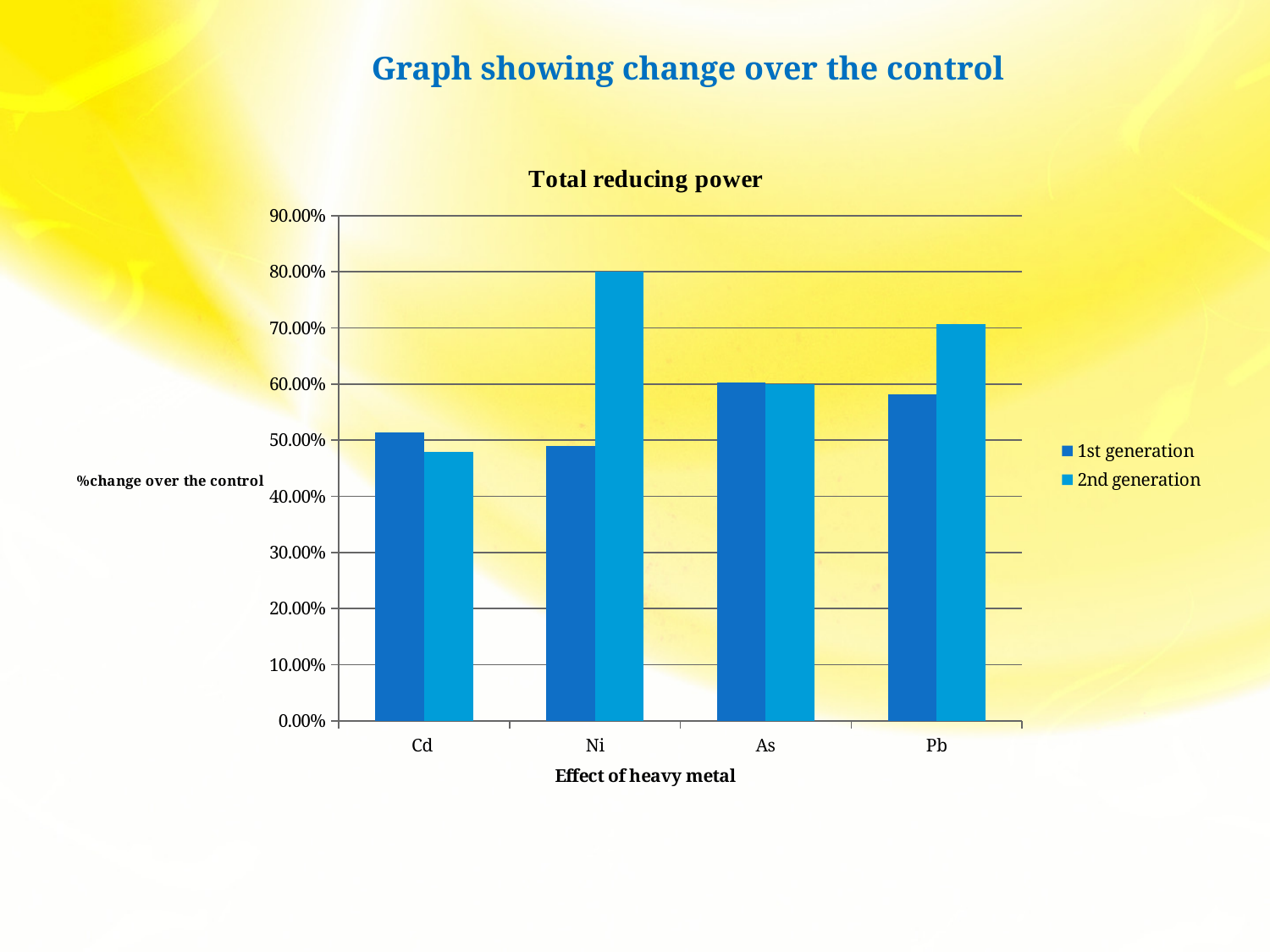
Which bar is the tallest in the whole chart? Ni, 2nd generation What is the label of the x axis? Effect of heavy metal Which category has the lowest 2nd generation value? Cd Which category has the highest 2nd generation value? Ni How many heavy metal categories are shown on the x axis? 4 What kind of chart is shown on the slide? bar chart For Ni, which is larger: the 1st generation or the 2nd generation value? 2nd generation Is the 2nd generation value for Cd greater or less than 60.00%? less Is the 2nd generation value for Ni greater or less than 70.00%? greater What is the title of the chart? Total reducing power How many series does the legend list? 2 For Pb, which is larger: the 1st generation or the 2nd generation value? 2nd generation